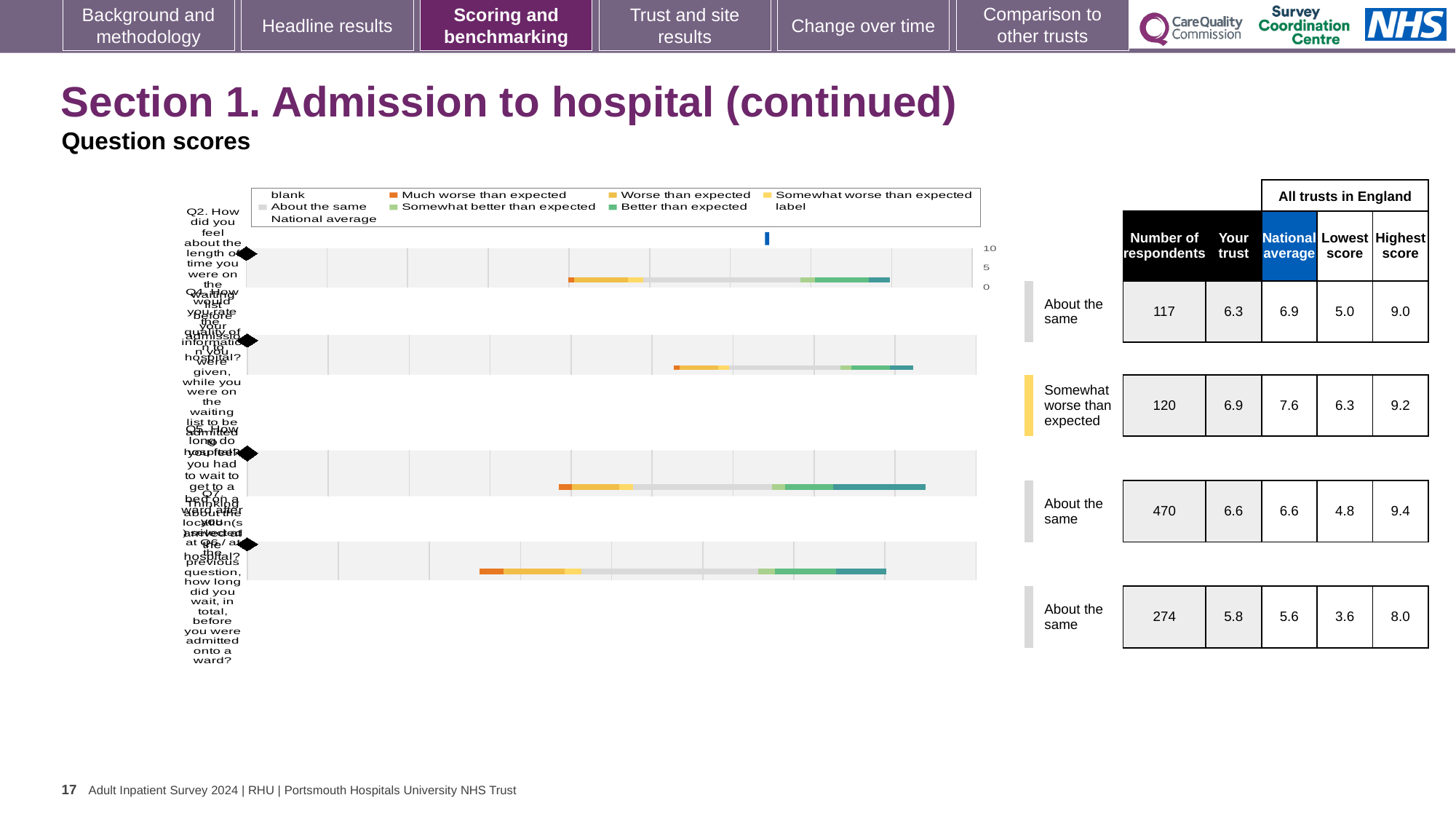
How many of the question rows are labelled 'About the same'? 3 How many question rows are plotted in the chart? 4 Which question row has the largest number of respondents? The third row (470 respondents) What benchmark label is shown for the question row with 120 respondents? Somewhat worse than expected For the question row with 117 respondents, how much higher is the national average than the trust's score? 0.6 For the question row with 470 respondents, what is the difference between the highest score and the lowest score? 4.6 What kind of chart is used to show the question scores on this slide? bar chart What is the 'Your trust' score for the question row with 117 respondents? 6.3 What is the lowest score in England for the question row with 274 respondents? 3.6 What is the national average for the question row with 120 respondents? 7.6 What is the highest score in England for the question row with 470 respondents? 9.4 For the question row with 120 respondents, which is larger: the trust's score or the national average? National average